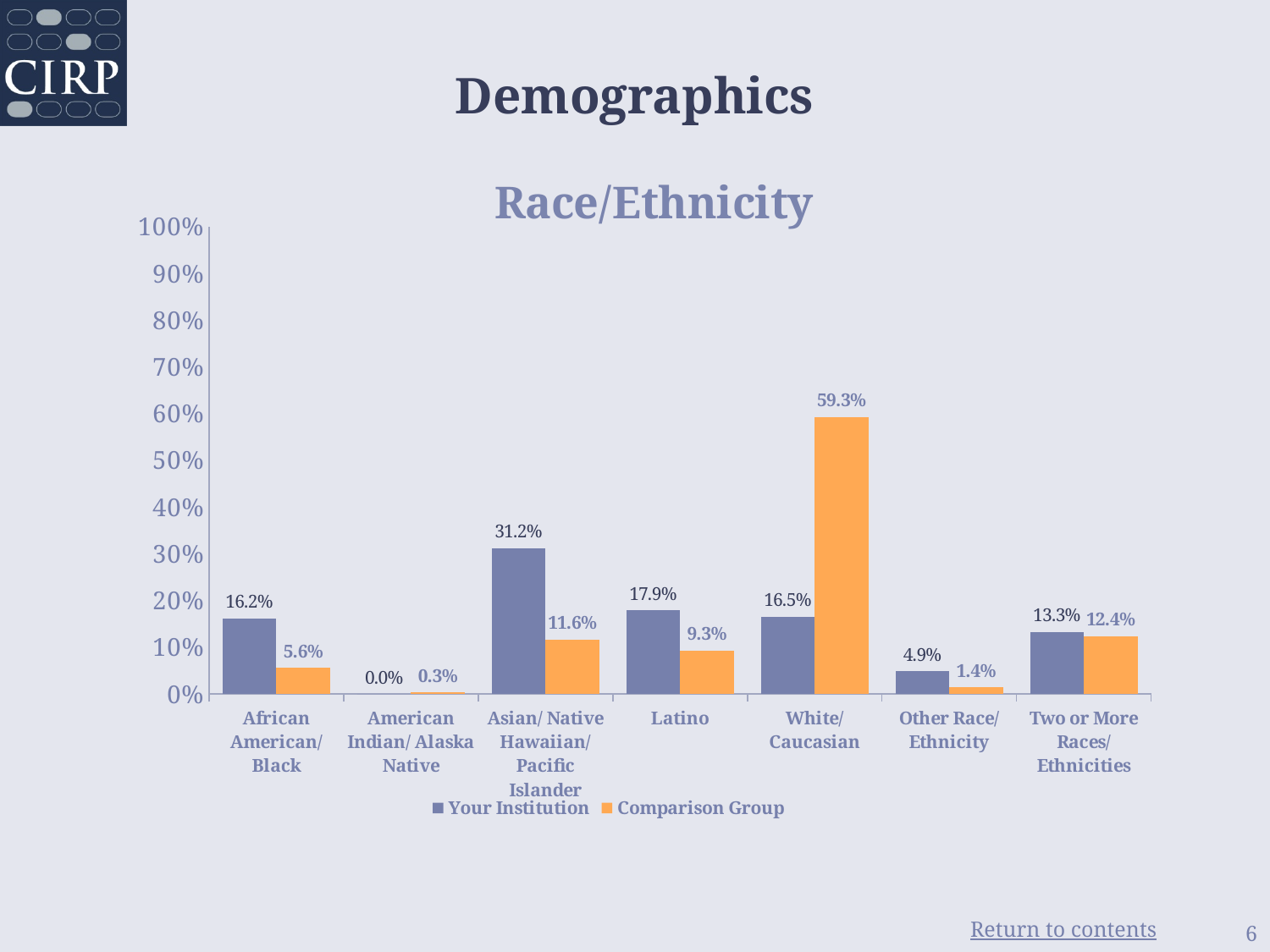
Which category has the lowest Your Institution value? American Indian/ Alaska Native What kind of chart is shown on the slide? bar chart Is the Your Institution value for Asian/ Native Hawaiian/ Pacific Islander greater or less than 30%? greater What is the Comparison Group value for White/ Caucasian? 59.3% What is the Comparison Group value for Latino? 9.3% What is the Your Institution value for Asian/ Native Hawaiian/ Pacific Islander? 31.2% What is the difference between the Comparison Group and Your Institution values for White/ Caucasian? 42.8% How many series does the legend list? 2 What is the Your Institution value for Other Race/ Ethnicity? 4.9% Which category has the highest Comparison Group value? White/ Caucasian How many race/ethnicity categories are shown on the chart? 7 Which is larger for African American/ Black: Your Institution or Comparison Group? Your Institution